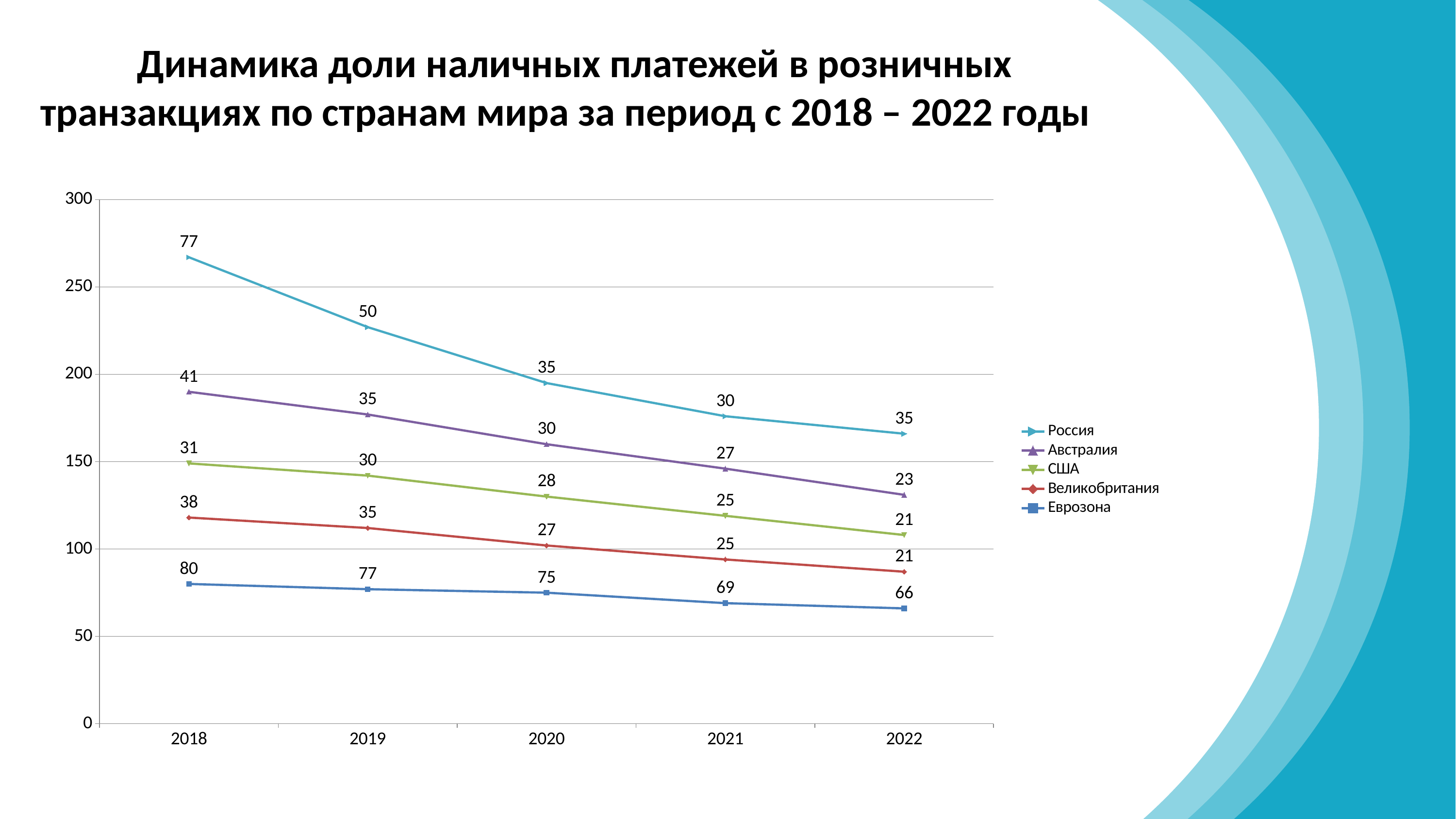
What kind of chart is shown on the slide? line chart Do the values for Еврозона rise or fall from 2018 to 2022? fall How many series does the legend list? 5 Which is larger in 2021: the value for Австралия or the value for США? Австралия What is the difference between the Россия values in 2018 and 2019? 27 Which series has the highest value in 2018? Еврозона What is the value for Австралия in 2020? 30 Which series has the lowest value in 2018? США What is the value for Еврозона in 2022? 66 How many years are shown on the x axis? 5 What is the value for Россия in 2018? 77 What is the value for Великобритания in 2019? 35